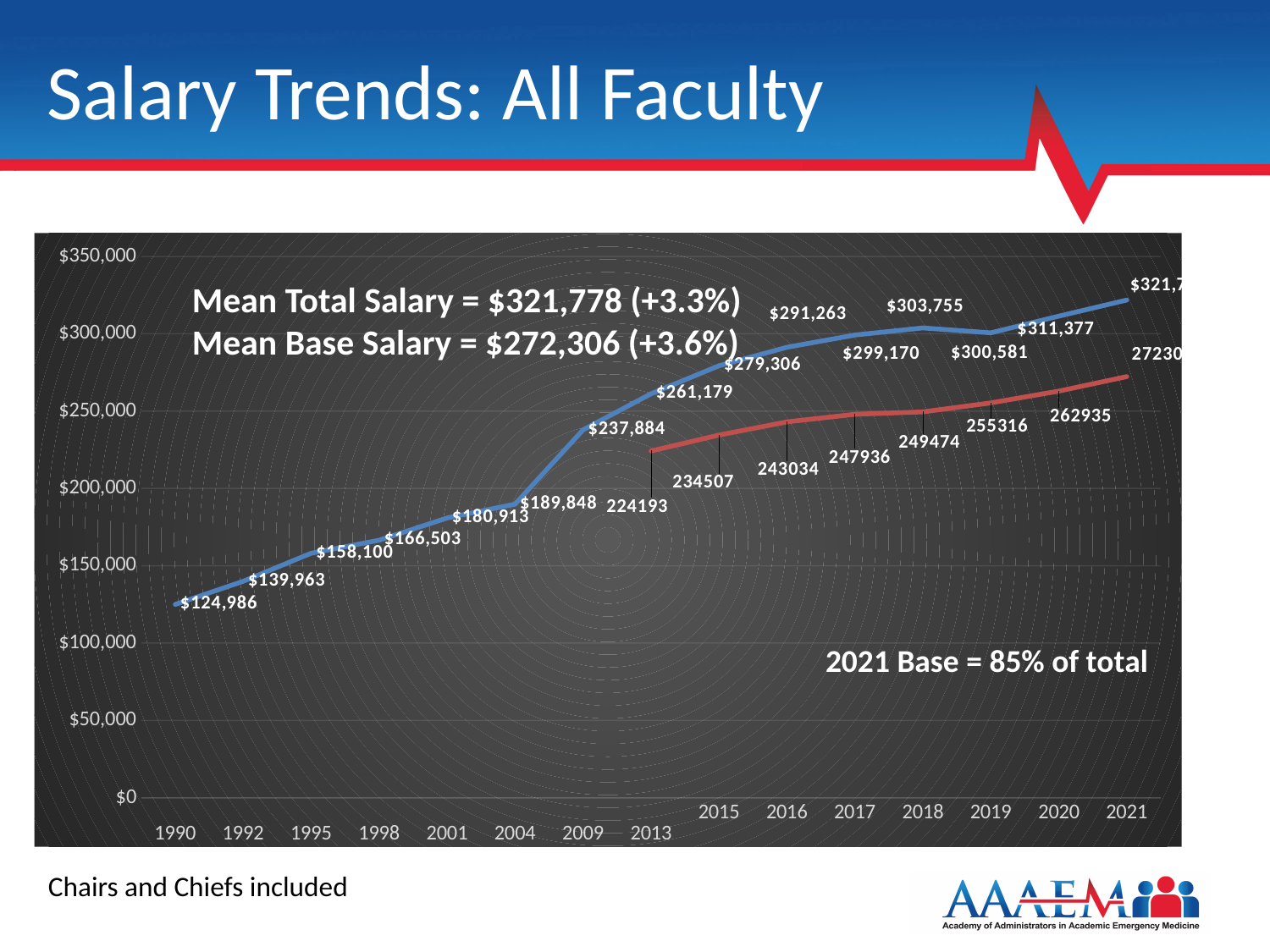
By how much did the blue (total salary) line increase from 1990 to 1992? $14,977 Which year has the larger blue (total salary) value, 2018 or 2019? 2018 In which year is the blue (total salary) line at its highest? 2021 What is the difference between the blue (total salary) value and the red (base salary) value in 2013? $36,986 What kind of chart is shown on the slide? line chart What is the value of the blue (total salary) line in 2009? $237,884 How many years are shown on the x axis? 15 What is the value of the red (base salary) line in 2020? 262935 What is the value of the blue (total salary) line in 1990? $124,986 What is the value of the red (base salary) line in 2013? 224193 In which year is the blue (total salary) line at its lowest? 1990 Is the value of the red (base salary) line in 2017 greater or less than $250,000? less